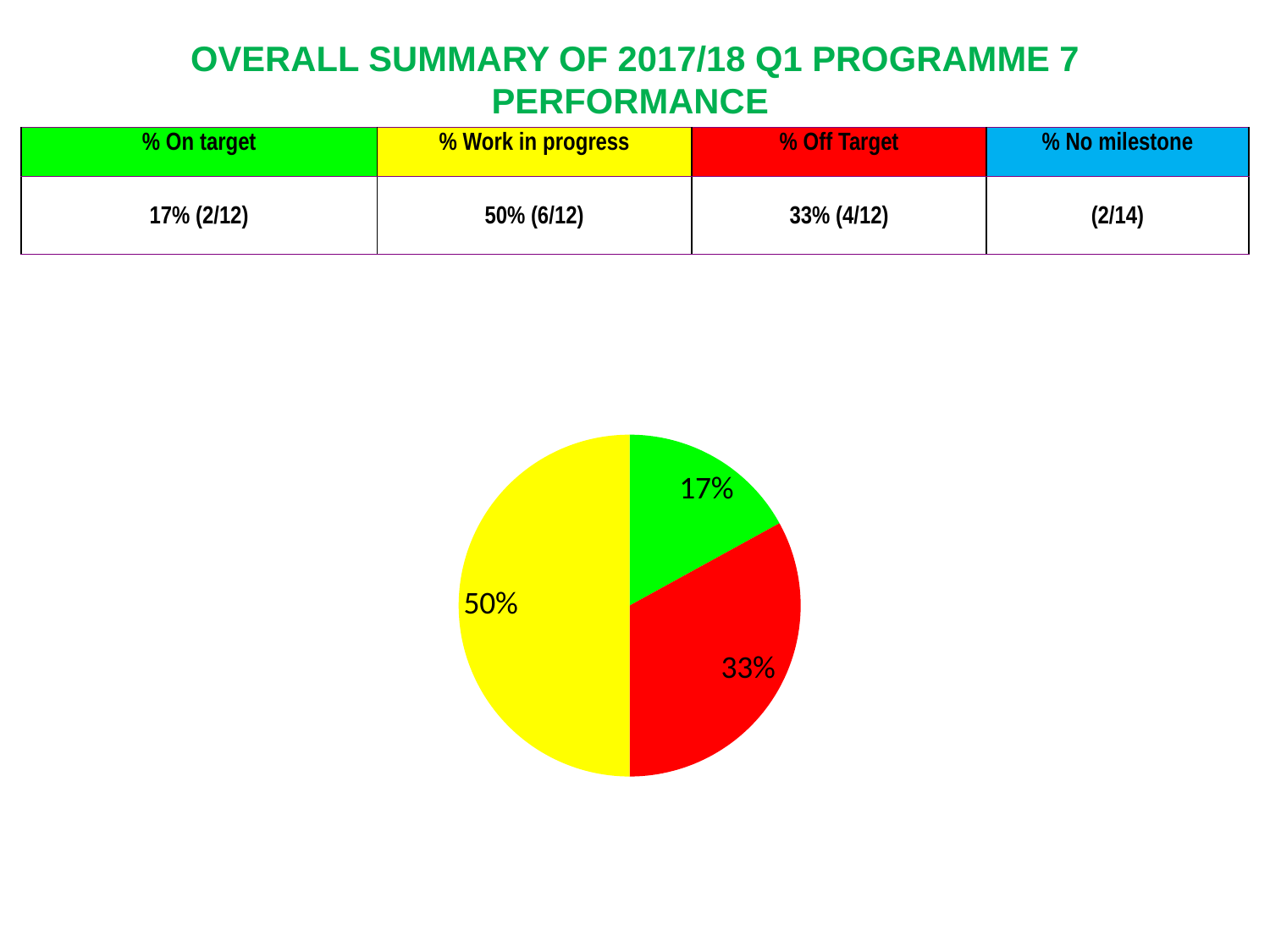
What is the difference in percentage points between the red slice and the green slice of the pie chart? 16 How many slices does the pie chart have? 3 What percentage is shown on the yellow slice of the pie chart? 50% What is the difference in percentage points between the yellow slice and the red slice of the pie chart? 17 What kind of chart is shown on the slide? pie chart Which slice of the pie chart is the largest? the yellow slice (50%) What percentage is shown on the red slice of the pie chart? 33% Which slice of the pie chart is the smallest? the green slice (17%) Which is larger in the pie chart, the red slice or the green slice? the red slice What percentage is shown on the green slice of the pie chart? 17% Which colour in the pie chart corresponds to '% Off Target' according to the table above it? red What share of the pie does the yellow slice represent? 50%